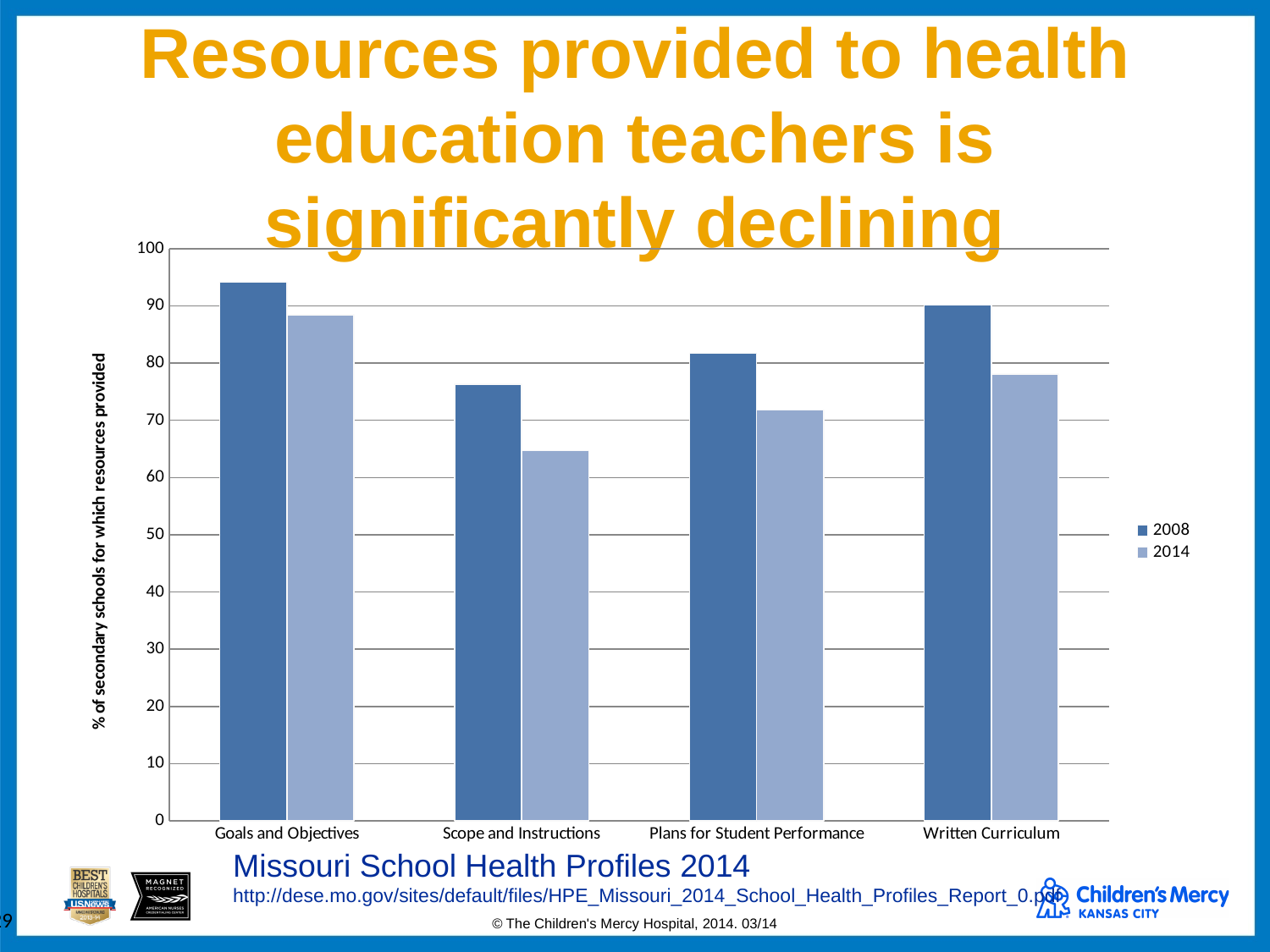
For Plans for Student Performance, which is larger, the 2008 value or the 2014 value? 2008 Which two years are listed in the chart's legend? 2008 and 2014 Is the 2014 value for Scope and Instructions greater or less than 70? less Is the 2014 value for Written Curriculum greater or less than 80? less How many series does the chart's legend list? 2 Which category has the highest value for 2008? Goals and Objectives Is the 2008 value for Goals and Objectives greater or less than 90? greater How many categories are shown on the x axis of the chart? 4 What is the label of the chart's vertical axis? % of secondary schools for which resources provided Which category has the lowest value for 2014? Scope and Instructions What kind of chart is shown on the slide? bar chart Which category has the lowest value for 2008? Scope and Instructions